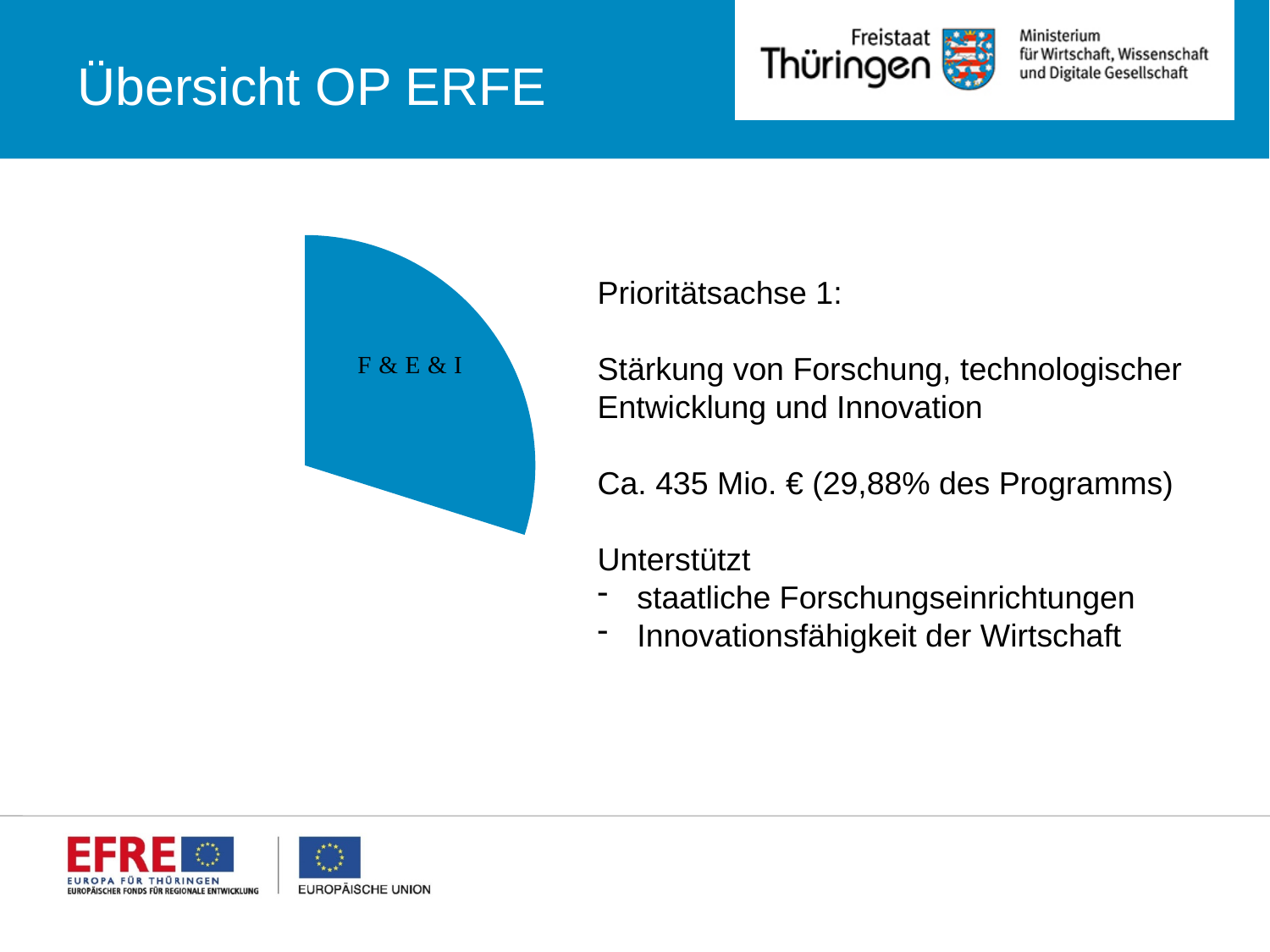
What amount is given on the slide for the F & E & I slice (Prioritätsachse 1)? Ca. 435 Mio. € What kind of chart is shown on the slide? pie chart How many slices of the pie chart are visible on the slide? 1 What colour is the F & E & I slice of the pie chart? blue What share of the programme does the F & E & I slice represent, according to the slide? 29,88% Is the share of the F & E & I slice greater or less than 50%? less What label is printed on the visible slice of the pie chart? F & E & I